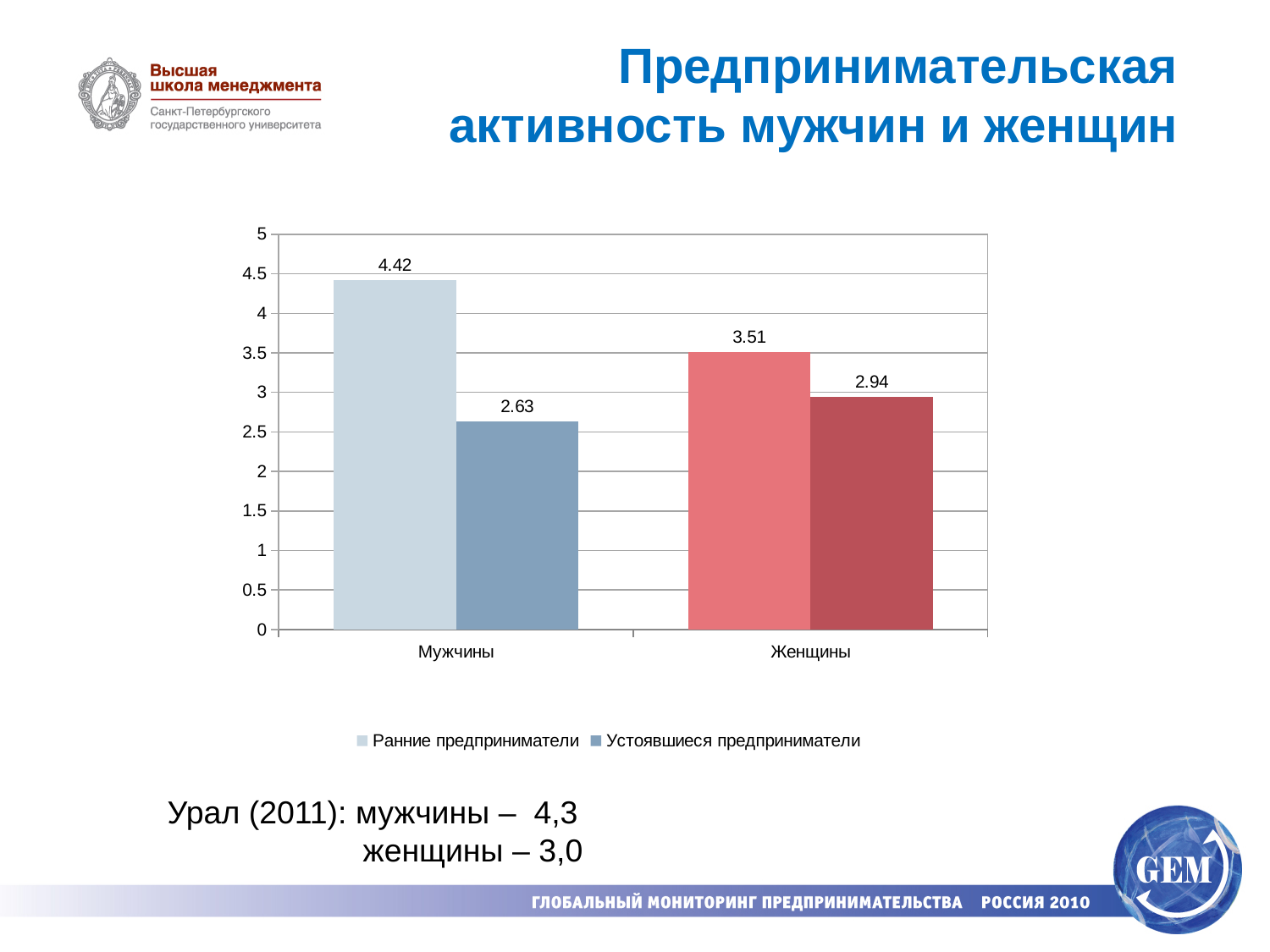
How many categories are shown on the x axis? 2 What is the difference between the Ранние предприниматели values for Мужчины and Женщины? 0.91 How many series does the legend list? 2 Which category has the highest value for Ранние предприниматели? Мужчины Is the value for Ранние предприниматели among Женщины greater or less than 3? greater What is the difference between Ранние предприниматели and Устоявшиеся предприниматели for Мужчины? 1.79 What kind of chart is shown on the slide? bar chart Which is larger: Устоявшиеся предприниматели for Мужчины or for Женщины? Женщины What is the value for Устоявшиеся предприниматели among Мужчины? 2.63 What is the value for Устоявшиеся предприниматели among Женщины? 2.94 What is the value for Ранние предприниматели among Мужчины? 4.42 Which bar has the lowest value on the chart? Устоявшиеся предприниматели, Мужчины